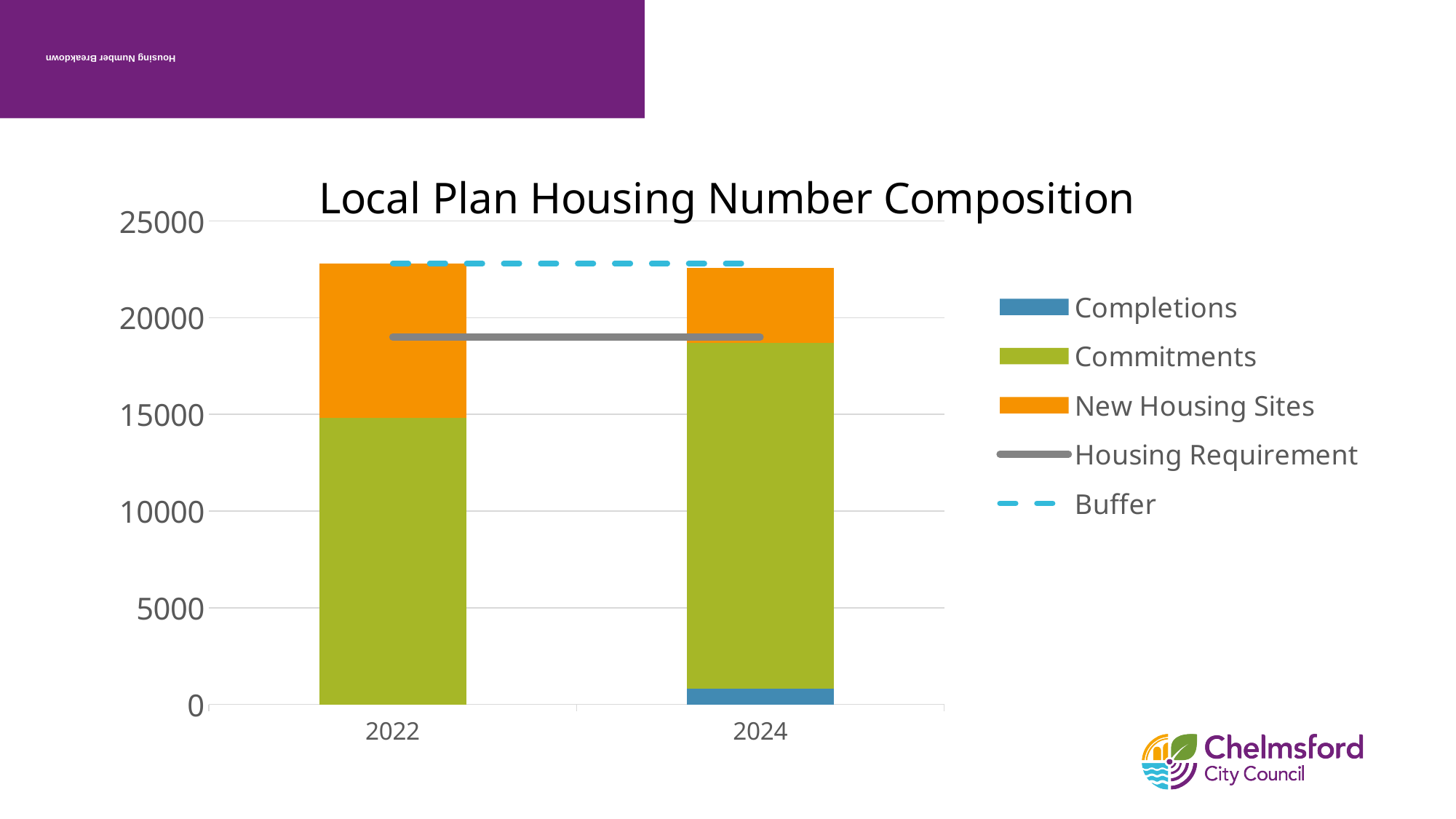
Is the Housing Requirement line greater or less than 20000? less Is the Completions segment in the 2024 bar greater or less than 5000? less Which year has the larger Commitments segment, 2022 or 2024? 2024 What is the title of the chart? Local Plan Housing Number Composition Is the total height of the 2024 bar greater or less than 25000? less How many entries does the chart's legend list? 5 Which legend entry is drawn as a dashed line? Buffer How many years are shown on the x axis of the chart? 2 What kind of chart is shown on the slide? Stacked bar chart